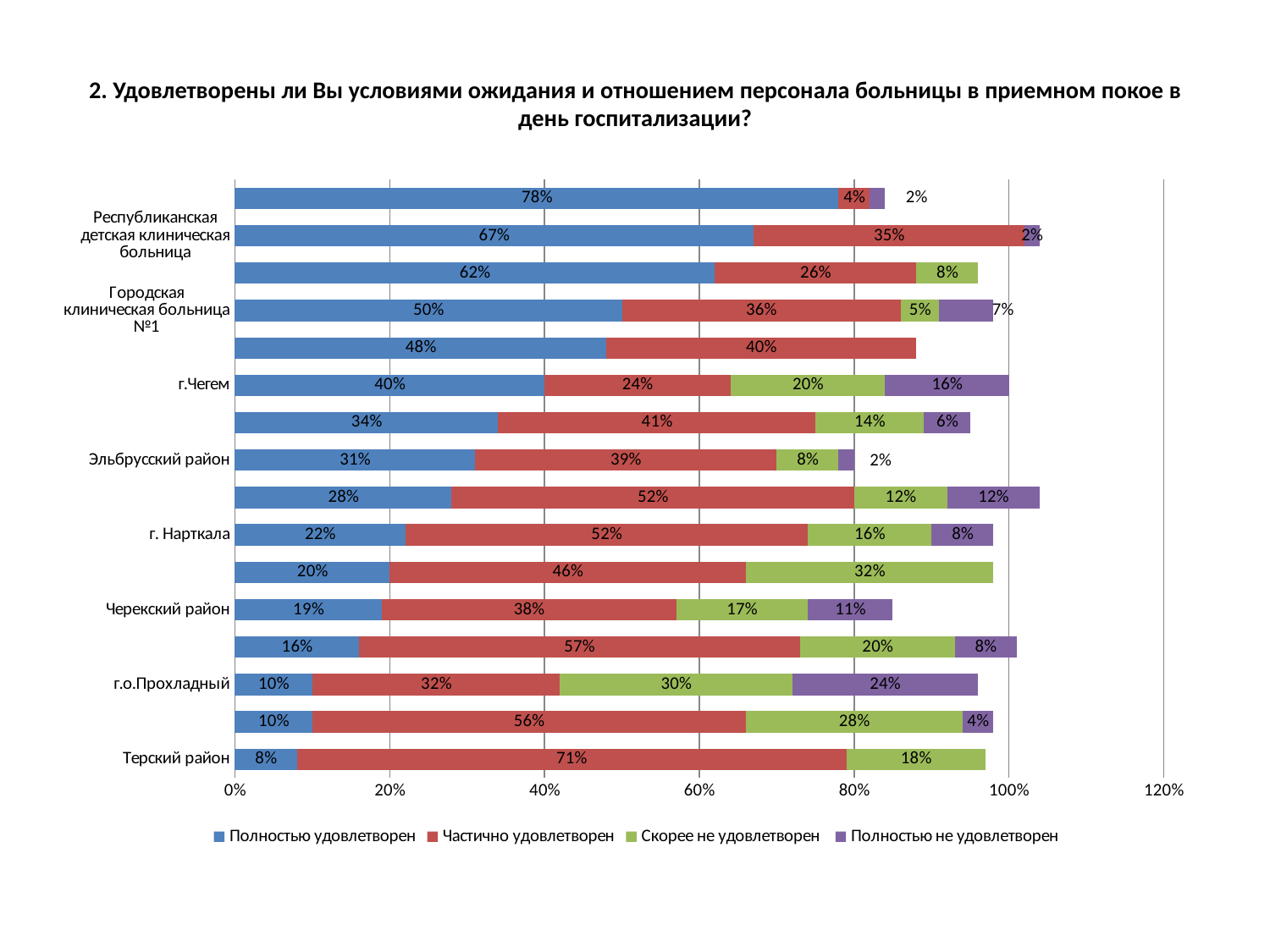
What is the total of the stacked bar for г.Чегем? 100% Which labeled category has the lowest 'Полностью удовлетворен' value? Терский район What is the value of 'Полностью не удовлетворен' for г.о.Прохладный? 24% How many series does the legend list? 4 What is the value of 'Частично удовлетворен' for Городская клиническая больница №1? 36% How many bars are plotted in the chart? 16 What is the value of 'Скорее не удовлетворен' for Черекский район? 17% What is the value of 'Частично удовлетворен' for Терский район? 71% For Терский район, what is the difference between 'Частично удовлетворен' and 'Полностью удовлетворен'? 63% What is the value of 'Полностью удовлетворен' for г.Чегем? 40% What kind of chart is shown on the slide? Stacked bar chart Which has the larger 'Полностью удовлетворен' value: г. Нарткала or Эльбрусский район? Эльбрусский район